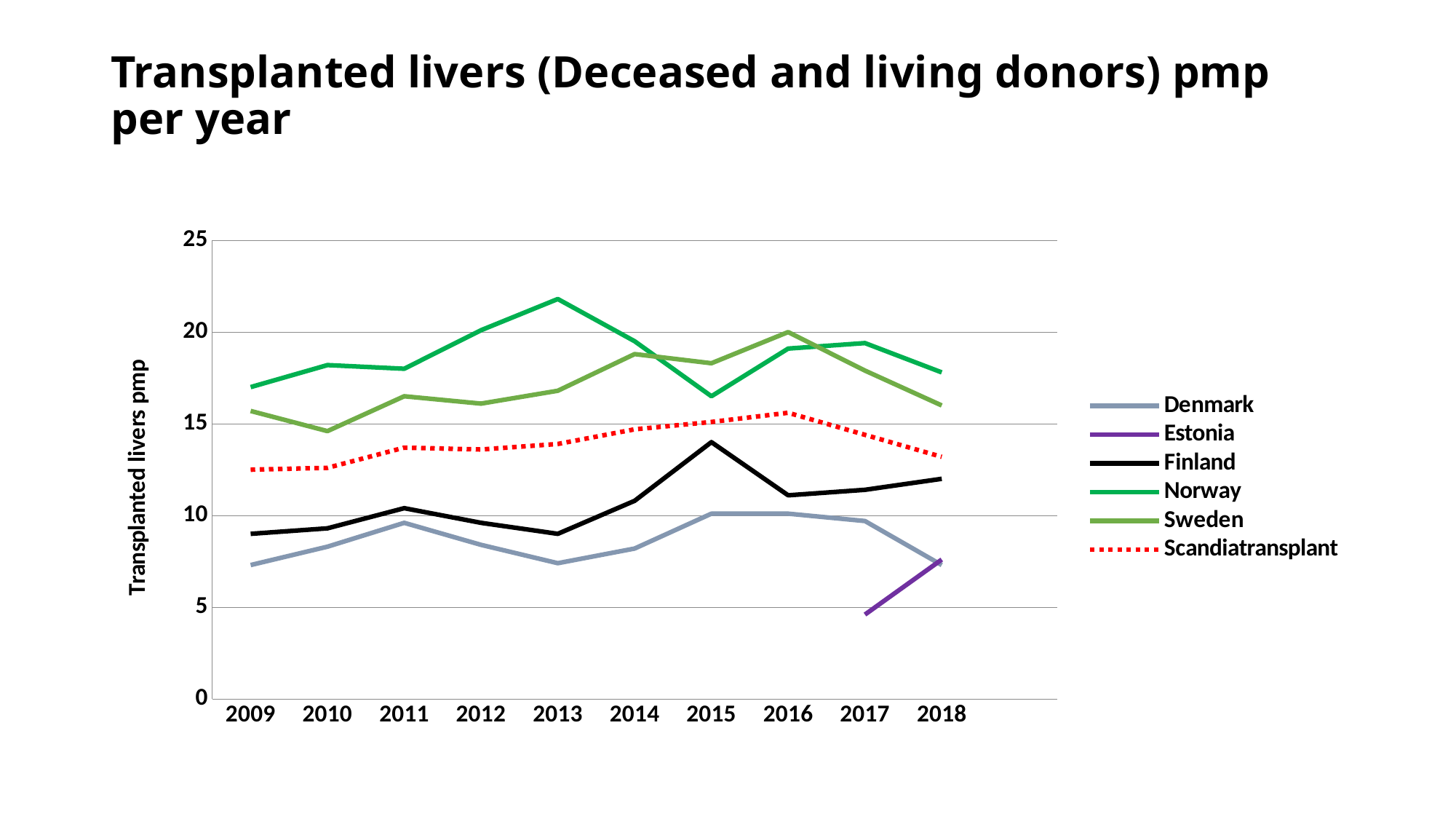
Is the value for Norway in 2013 greater or less than 20? greater Which series has the lowest value in 2017? Estonia In which year does Norway reach its highest value? 2013 How many years are shown on the x axis? 10 In 2015, which is higher, Finland or Denmark? Finland Which series is drawn with a dotted line? Scandiatransplant Does the value for Finland rise or fall from 2015 to 2016? fall Is the value for Denmark in 2009 greater or less than 10? less How many series does the legend list? 6 Which series has the highest value in 2013? Norway What kind of chart is shown on the slide? line chart